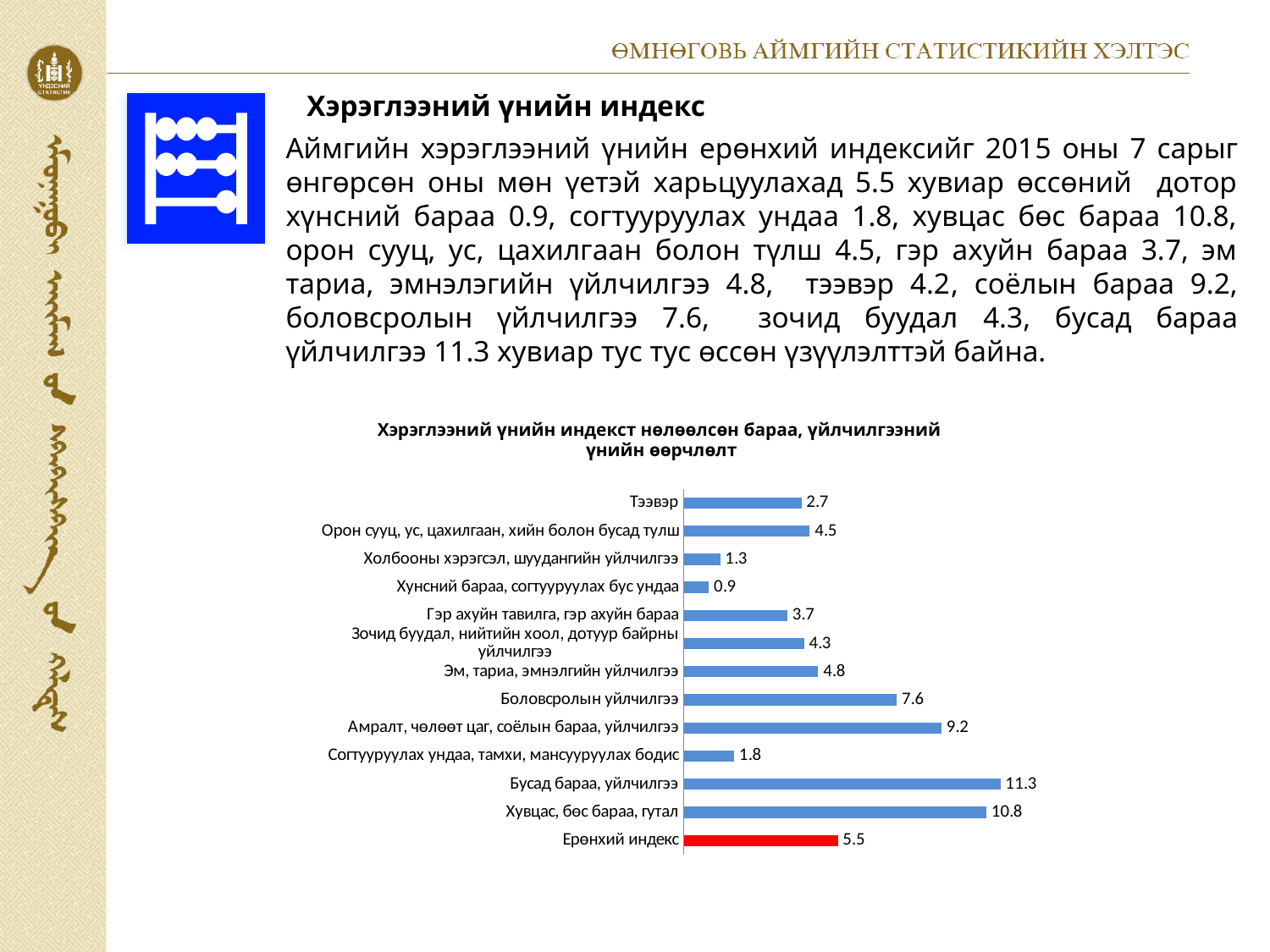
What is the value for Ерөнхий индекс? 5.5 What is the value for Хувцас, бөс бараа, гутал? 10.8 Which category's bar is coloured red? Ерөнхий индекс Which category has the highest value? Бусад бараа, үйлчилгээ Which category has the lowest value? Хүнсний бараа, согтууруулах бус ундаа What type of chart is shown on the slide? Bar chart What is the difference between the values for Амралт, чөлөөт цаг, соёлын бараа, үйлчилгээ and Боловсролын үйлчилгээ? 1.6 Which is larger: the value for Эм, тариа, эмнэлгийн үйлчилгээ or the value for Зочид буудал, нийтийн хоол, дотуур байрны үйлчилгээ? Эм, тариа, эмнэлгийн үйлчилгээ How many categories are plotted in the chart? 13 What is the difference between the values for Бусад бараа, үйлчилгээ and Хувцас, бөс бараа, гутал? 0.5 What is the value for Боловсролын үйлчилгээ? 7.6